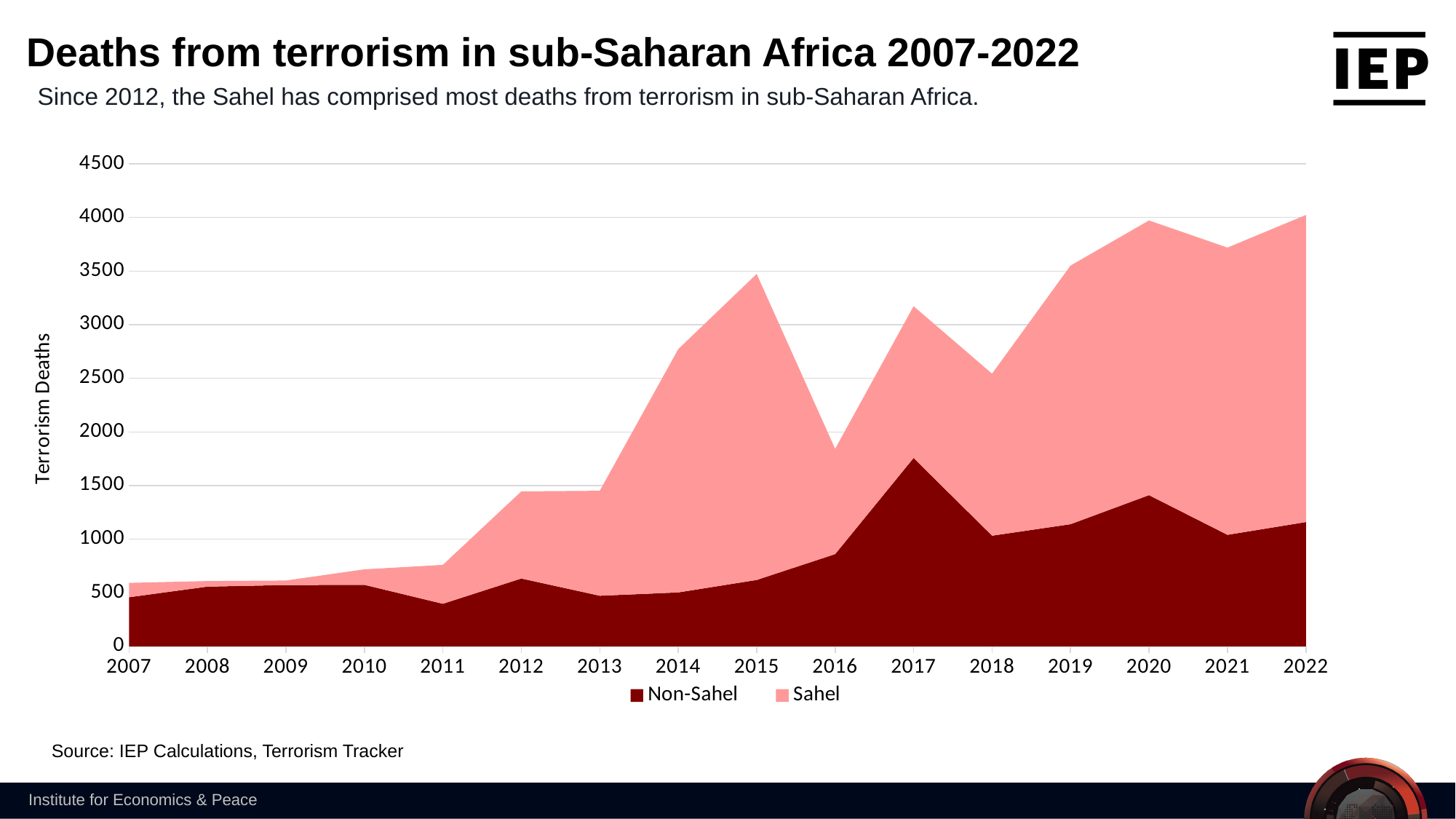
How many years are shown along the x axis? 16 In which year is the Non-Sahel value lowest? 2011 Overall, do total terrorism deaths rise or fall from 2007 to 2022? rise Is the total number of terrorism deaths in 2016 greater or less than 2000? less What kind of chart is shown on the slide? Stacked area chart How many series does the legend list? 2 Is the total number of terrorism deaths in 2015 greater or less than 3000? greater What is the label on the y axis? Terrorism Deaths Which two series are listed in the legend? Non-Sahel and Sahel In which year is the Non-Sahel value highest? 2017 Which year has the larger total number of terrorism deaths, 2015 or 2016? 2015 Is the Non-Sahel value in 2017 greater or less than 1500? greater